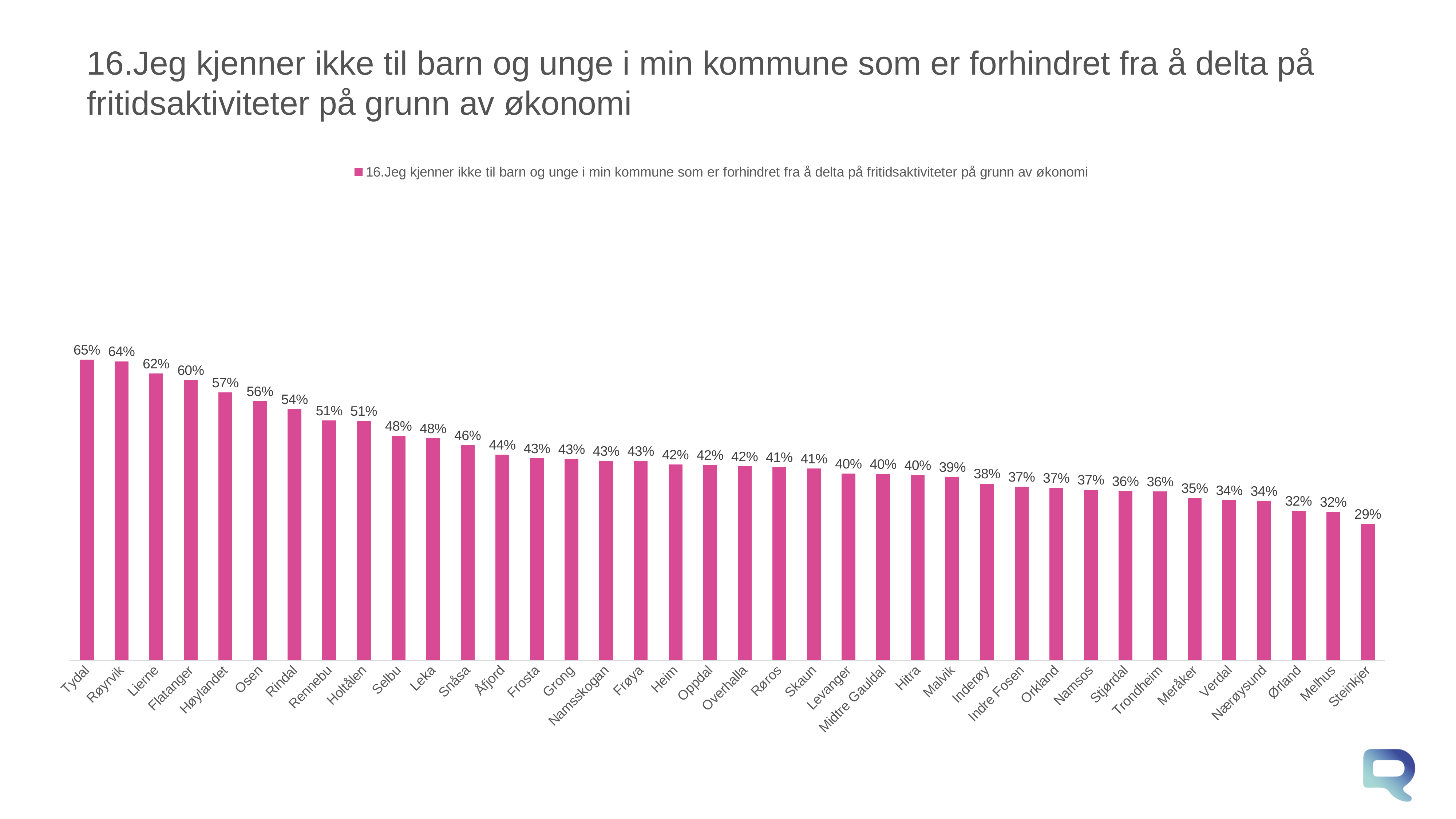
How many municipalities are shown in the chart? 38 What is the difference between the values for Tydal and Steinkjer? 36% Which municipality has the lowest value? Steinkjer What is the difference between the values for Lierne and Malvik? 23% What kind of chart is shown on the slide? Bar chart What is the value for Trondheim? 36% What is the value for Frøya? 43% Do the values rise or fall from left to right along the x axis? Fall Which has a larger value, Osen or Verdal? Osen Which municipality has the highest value? Tydal What is the value for Tydal? 65% What is the value for Steinkjer? 29%